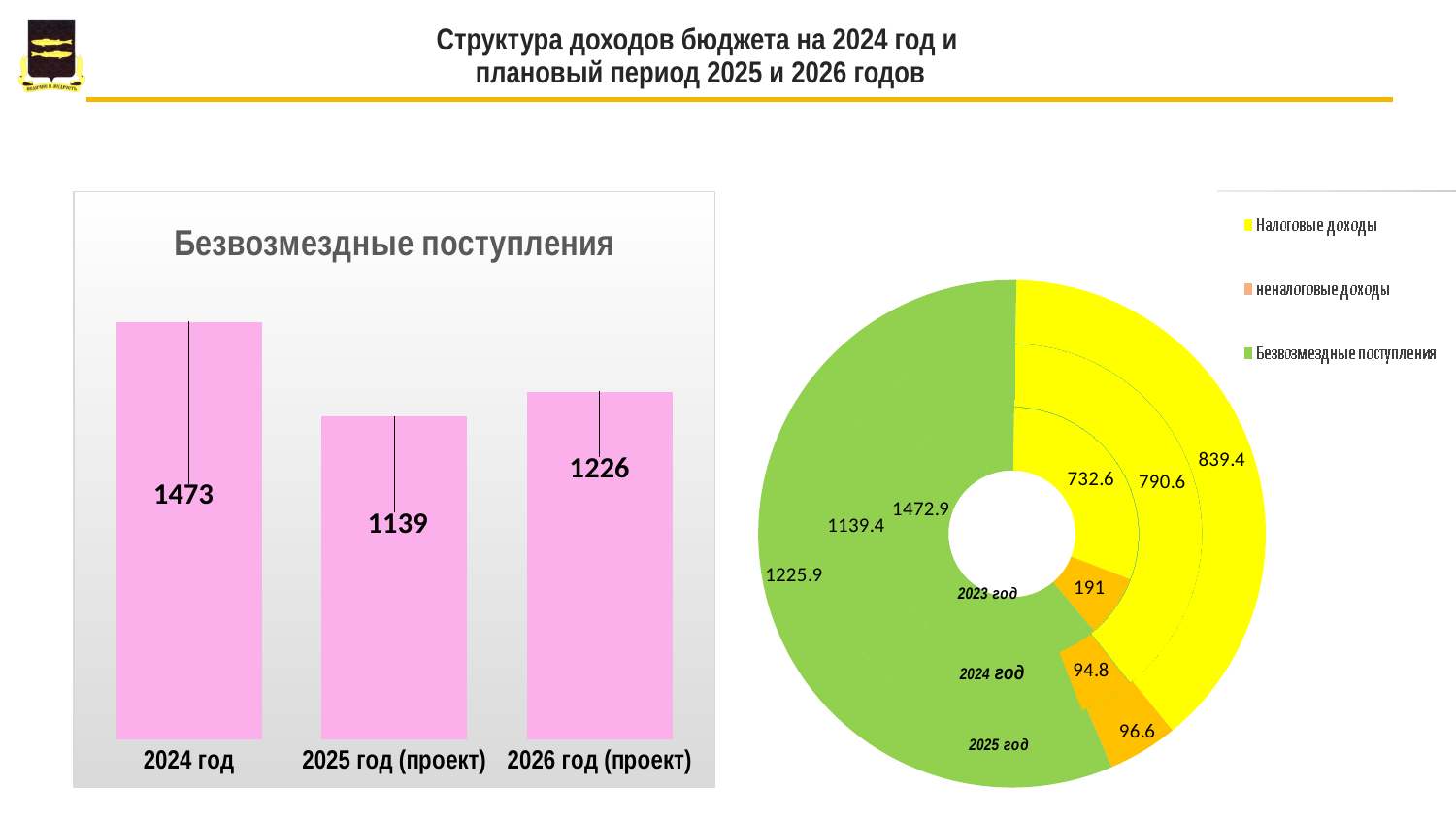
What kind of chart is the chart on the right side of the slide? Doughnut chart In the bar chart titled 'Безвозмездные поступления', what is the value for 2024 год? 1473 In the bar chart titled 'Безвозмездные поступления', which year has the lowest value? 2025 год (проект) How many bars are in the bar chart titled 'Безвозмездные поступления'? 3 In the bar chart titled 'Безвозмездные поступления', what is the difference between the values for 2026 год (проект) and 2025 год (проект)? 87 What kind of chart is the chart on the left side of the slide? Bar chart In the bar chart titled 'Безвозмездные поступления', which is larger: the value for 2025 год (проект) or 2026 год (проект)? 2026 год (проект) In the bar chart titled 'Безвозмездные поступления', what is the difference between the values for 2024 год and 2025 год (проект)? 334 In the bar chart titled 'Безвозмездные поступления', what is the value for 2026 год (проект)? 1226 In the bar chart titled 'Безвозмездные поступления', which year has the highest value? 2024 год How many series does the legend of the doughnut chart on the right list? 3 In the bar chart titled 'Безвозмездные поступления', what is the value for 2025 год (проект)? 1139